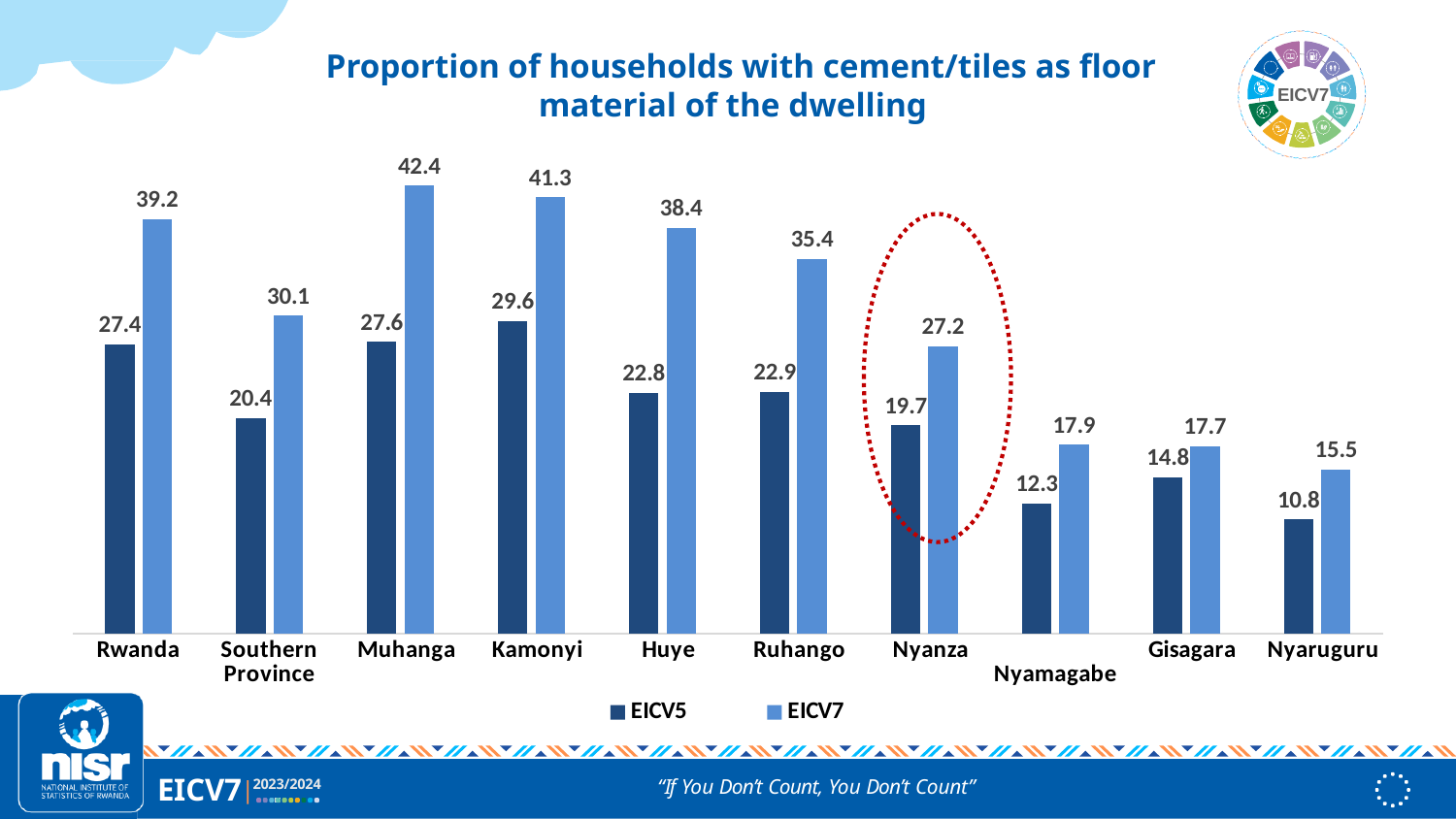
Which is larger, the EICV7 value for Huye or the EICV7 value for Ruhango? Huye Which category is highlighted with a red dotted circle? Nyanza How many categories are shown on the x axis? 10 What kind of chart is shown on the slide? Bar chart Which category has the highest EICV7 value? Muhanga What is the EICV5 value for Nyanza? 19.7 What is the difference between the EICV7 values for Kamonyi and Nyaruguru? 25.8 How many series does the legend list? 2 What is the difference between the EICV7 and EICV5 values for Nyanza? 7.5 What is the EICV7 value for Rwanda? 39.2 What is the EICV7 value for Muhanga? 42.4 Which category has the lowest EICV5 value? Nyaruguru